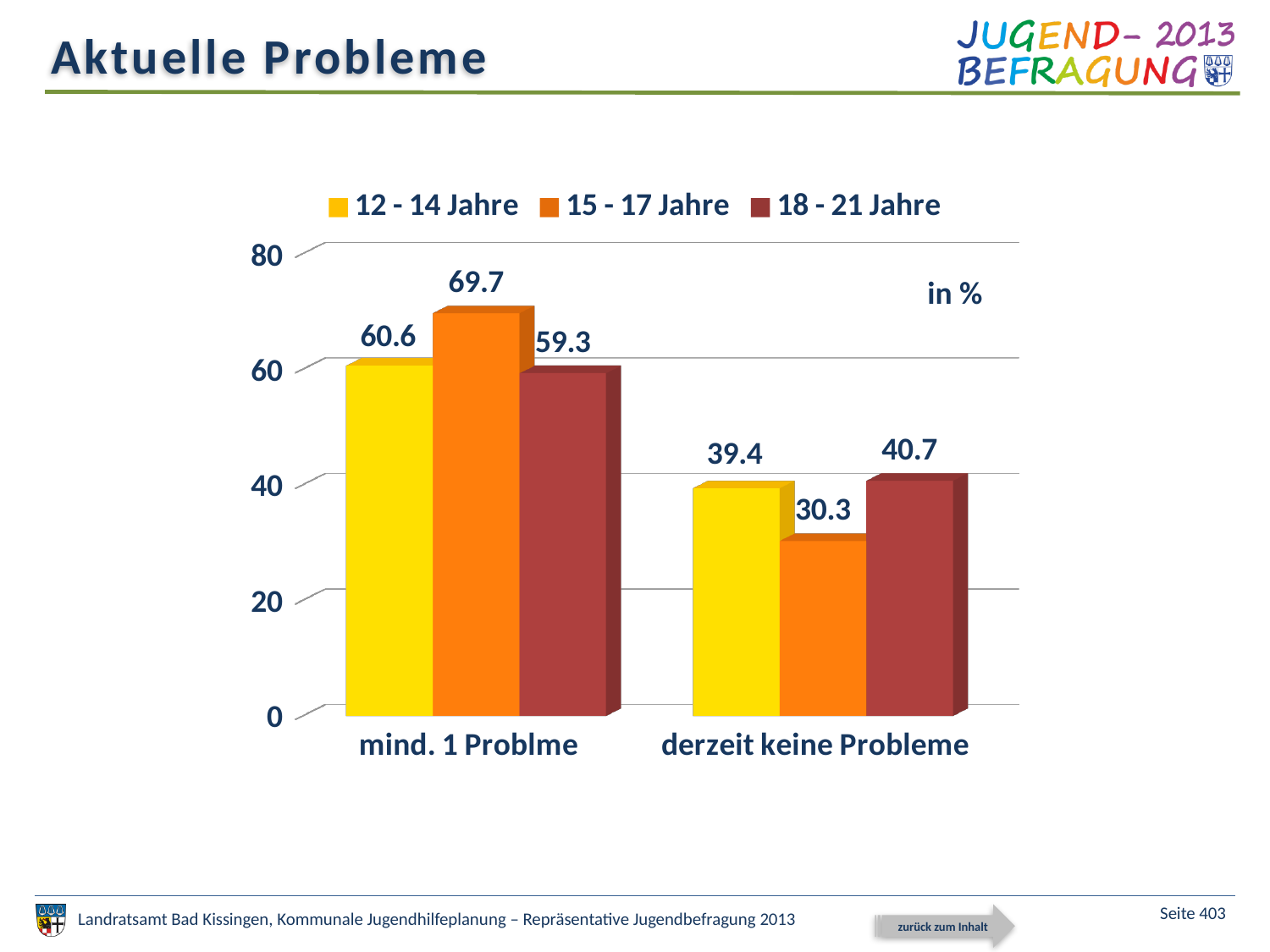
What is the value for 12 - 14 Jahre in the 'mind. 1 Problme' category? 60.6 Which age group has the highest value in the 'mind. 1 Problme' category? 15 - 17 Jahre What is the value for 18 - 21 Jahre in the 'mind. 1 Problme' category? 59.3 What is the value for 15 - 17 Jahre in the 'derzeit keine Probleme' category? 30.3 What kind of chart is shown on the slide? bar chart Which age group has the lowest value in the 'derzeit keine Probleme' category? 15 - 17 Jahre What is the difference between the 15 - 17 Jahre values for 'mind. 1 Problme' and 'derzeit keine Probleme'? 39.4 How many series does the legend list? 3 Which is larger: the 12 - 14 Jahre value for 'mind. 1 Problme' or the 18 - 21 Jahre value for 'mind. 1 Problme'? 12 - 14 Jahre What is the difference between the 12 - 14 Jahre and 18 - 21 Jahre values in the 'derzeit keine Probleme' category? 1.3 How many categories are shown on the x axis? 2 Is the value for 15 - 17 Jahre in 'derzeit keine Probleme' greater or less than 40? less